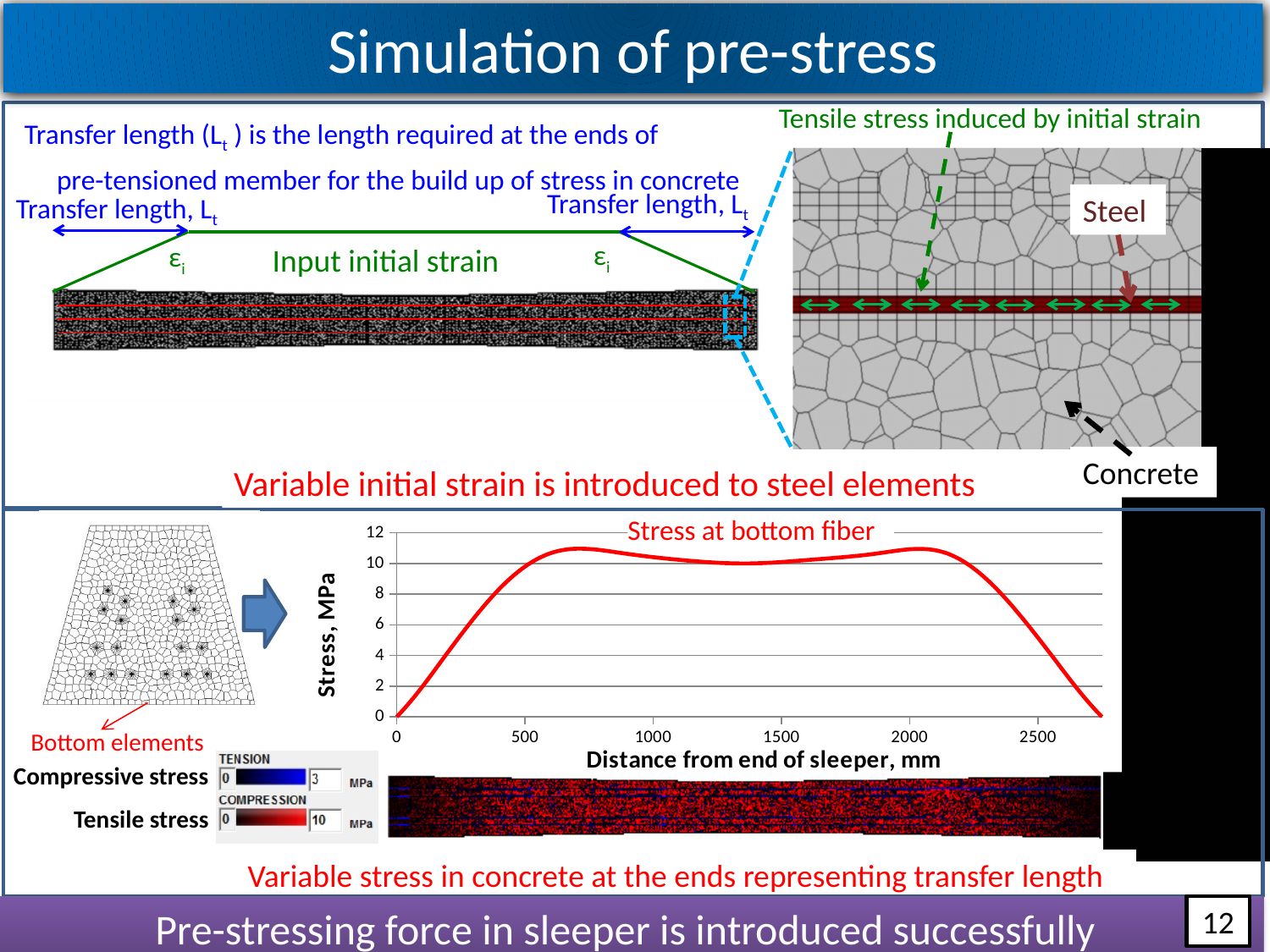
What is the title of the chart in the lower part of the slide? Stress at bottom fiber In the 'Stress at bottom fiber' chart, is the stress at a distance of 2500 mm greater or less than 8 MPa? less In the 'Stress at bottom fiber' chart, which is larger: the stress at 500 mm or the stress at 2500 mm? 500 mm In the 'Stress at bottom fiber' chart, is the stress at a distance of 500 mm greater or less than 8 MPa? greater In the 'Stress at bottom fiber' chart, which is larger: the stress at 0 mm or the stress at 1000 mm? 1000 mm In the 'Stress at bottom fiber' chart, does the stress rise or fall as the distance increases from 0 to 500 mm? rise In the 'Stress at bottom fiber' chart, is the stress at a distance of 0 mm greater or less than 2 MPa? less How many data series are plotted in the 'Stress at bottom fiber' chart? 1 What is the x-axis label of the 'Stress at bottom fiber' chart? Distance from end of sleeper, mm In the 'Stress at bottom fiber' chart, does the stress rise or fall as the distance increases from 2000 to 2500 mm? fall What kind of chart is the 'Stress at bottom fiber' chart? line chart